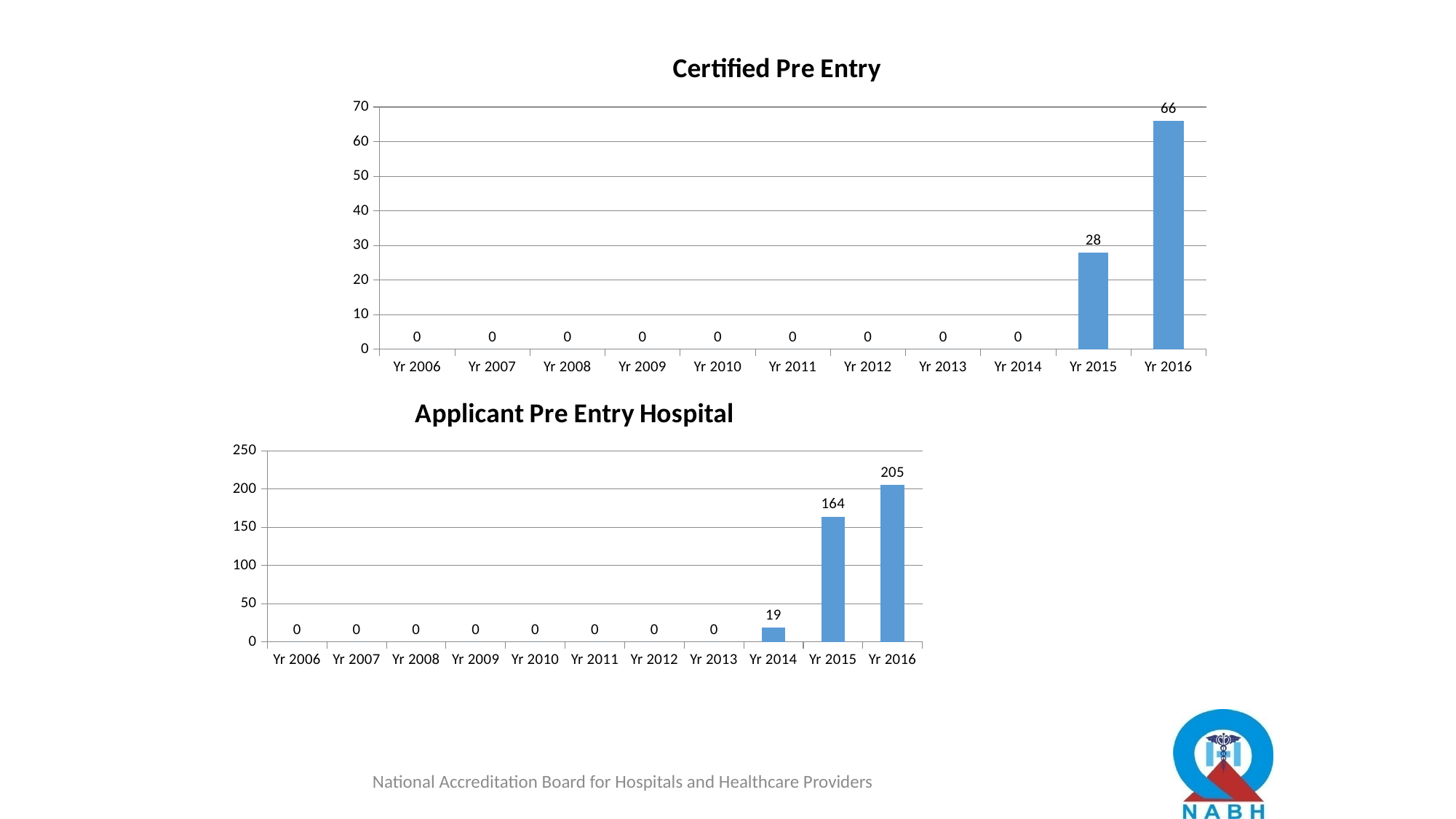
In the 'Applicant Pre Entry Hospital' chart, is the value for Yr 2015 greater or less than 150? greater In the 'Certified Pre Entry' chart, what is the value for Yr 2015? 28 In the 'Applicant Pre Entry Hospital' chart, what is the value for Yr 2016? 205 In the 'Applicant Pre Entry Hospital' chart, what is the value for Yr 2015? 164 In the 'Applicant Pre Entry Hospital' chart, what is the difference between the values for Yr 2016 and Yr 2015? 41 In the 'Certified Pre Entry' chart, what is the difference between the values for Yr 2016 and Yr 2015? 38 What kind of chart is the 'Applicant Pre Entry Hospital' chart? Bar chart In the 'Applicant Pre Entry Hospital' chart, do the values rise or fall from Yr 2014 to Yr 2016? Rise In the 'Applicant Pre Entry Hospital' chart, what is the value for Yr 2014? 19 In the 'Certified Pre Entry' chart, which year has the highest value? Yr 2016 In the 'Certified Pre Entry' chart, how many years are shown on the x axis? 11 In the 'Certified Pre Entry' chart, what is the value for Yr 2016? 66